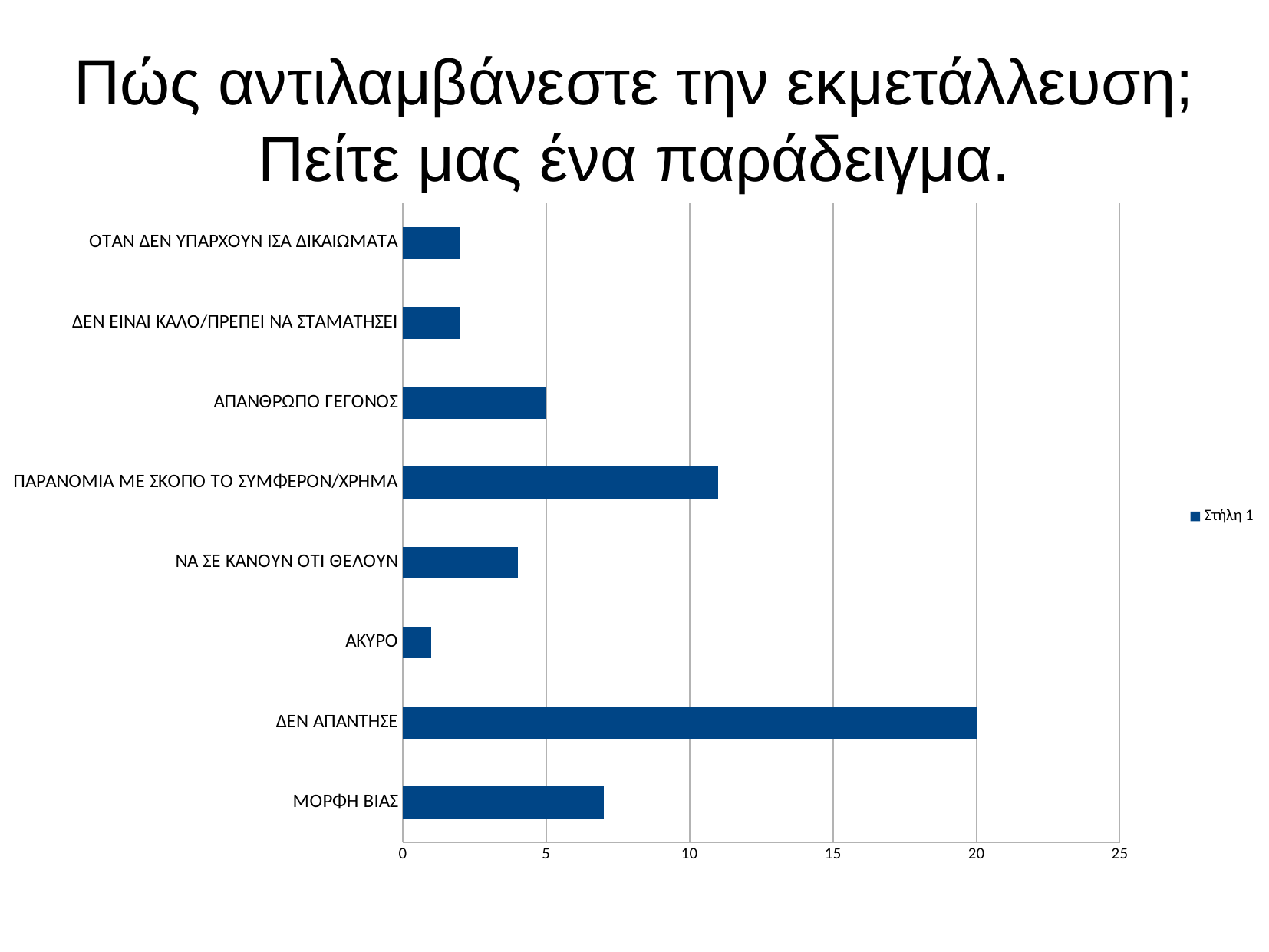
Which has the larger value, ΜΟΡΦΗ ΒΙΑΣ or ΝΑ ΣΕ ΚΑΝΟΥΝ ΟΤΙ ΘΕΛΟΥΝ? ΜΟΡΦΗ ΒΙΑΣ What is the value for ΔΕΝ ΑΠΑΝΤΗΣΕ? 20 What is the difference between the values for ΔΕΝ ΑΠΑΝΤΗΣΕ and ΑΠΑΝΘΡΩΠΟ ΓΕΓΟΝΟΣ? 15 Which category has the highest value? ΔΕΝ ΑΠΑΝΤΗΣΕ Which category has the lowest value? ΑΚΥΡΟ How many categories are plotted in the chart? 8 What is the name of the series shown in the legend? Στήλη 1 Is the value for ΠΑΡΑΝΟΜΙΑ ΜΕ ΣΚΟΠΟ ΤΟ ΣΥΜΦΕΡΟΝ/ΧΡΗΜΑ greater or less than 10? greater What type of chart is shown on the slide? Bar chart How many series does the legend list? 1 Is the value for ΝΑ ΣΕ ΚΑΝΟΥΝ ΟΤΙ ΘΕΛΟΥΝ greater or less than 5? less What is the value for ΑΠΑΝΘΡΩΠΟ ΓΕΓΟΝΟΣ? 5